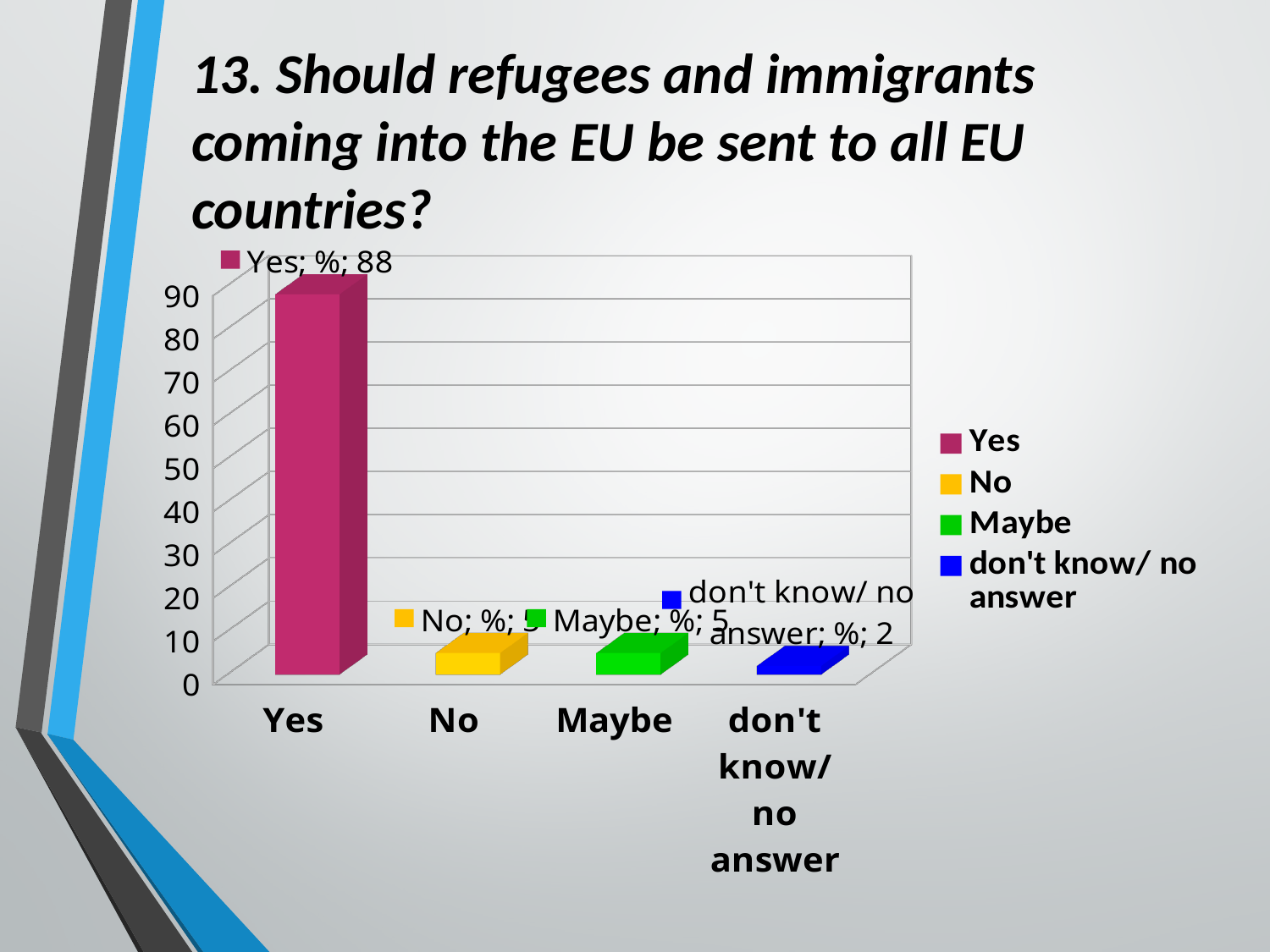
What is the value for don't know/ no answer? 2 Which category has the highest value? Yes How many categories are shown on the x axis? 4 What is the value for Yes? 88 Is the value for Yes greater or less than 80? greater What kind of chart is shown on the slide? bar chart Which category has the lowest value? don't know/ no answer What is the difference between the values for Maybe and don't know/ no answer? 3 What is the difference between the values for Yes and Maybe? 83 Which is larger, the value for Yes or the value for Maybe? Yes What is the value for Maybe? 5 How many entries does the legend list? 4